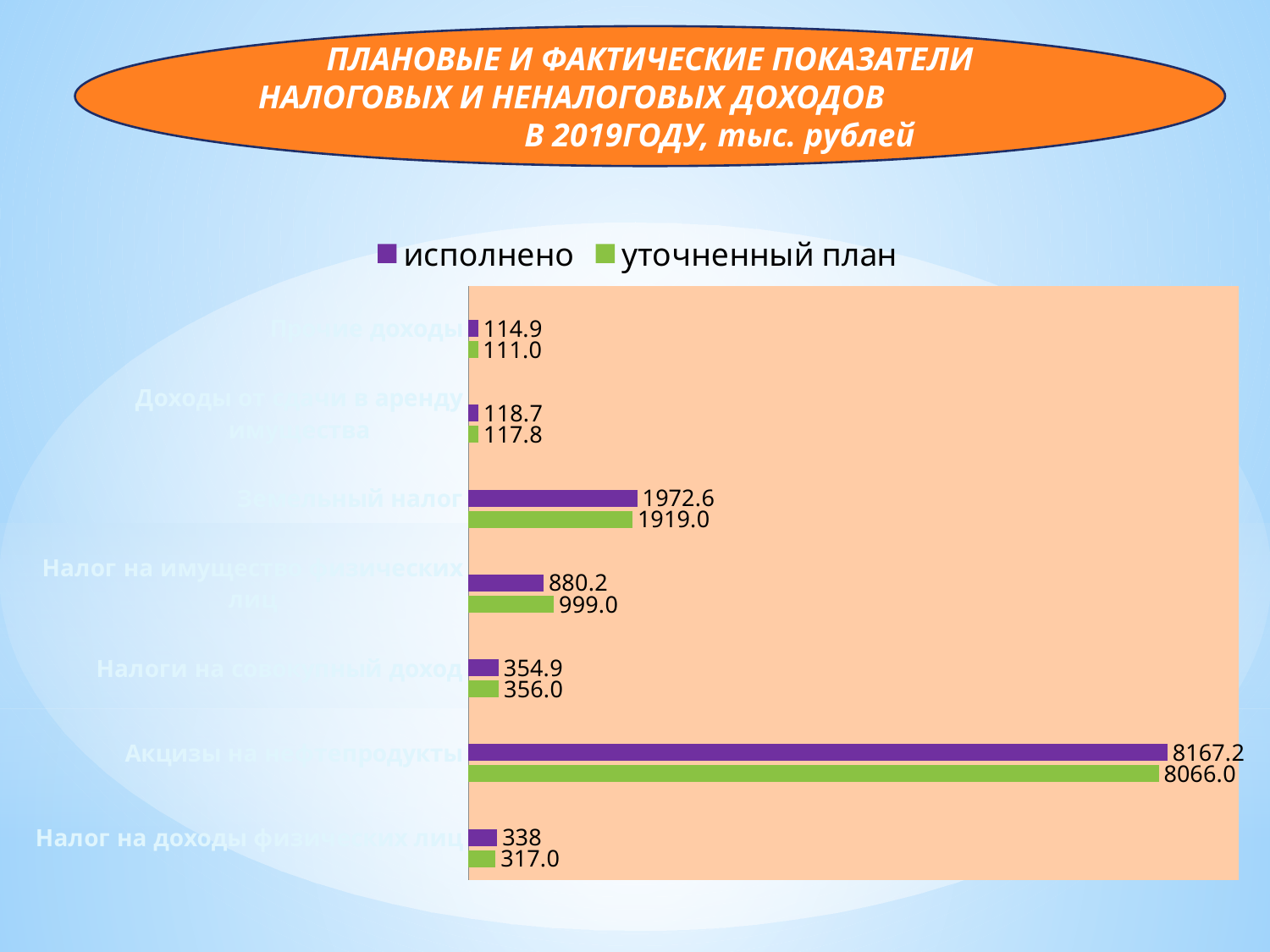
What type of chart is shown on the slide? bar chart For the third category from the top, how much larger is 'исполнено' (1972.6) than 'уточненный план' (1919.0)? 53.6 For the fourth category from the top, which series has the larger value: 'исполнено' or 'уточненный план'? уточненный план For the bottom category, which series has the larger value: 'исполнено' or 'уточненный план'? исполнено How many series does the chart legend list? 2 What is the 'исполнено' value for the bottom category of the chart? 338 What colour are the bars for the 'исполнено' series? purple How many categories are plotted in the chart? 7 What is the largest value in the 'исполнено' series? 8167.2 What is the 'уточненный план' value for the third category from the top? 1919.0 What is the 'исполнено' value for the topmost category? 114.9 What is the smallest value in the 'уточненный план' series? 111.0